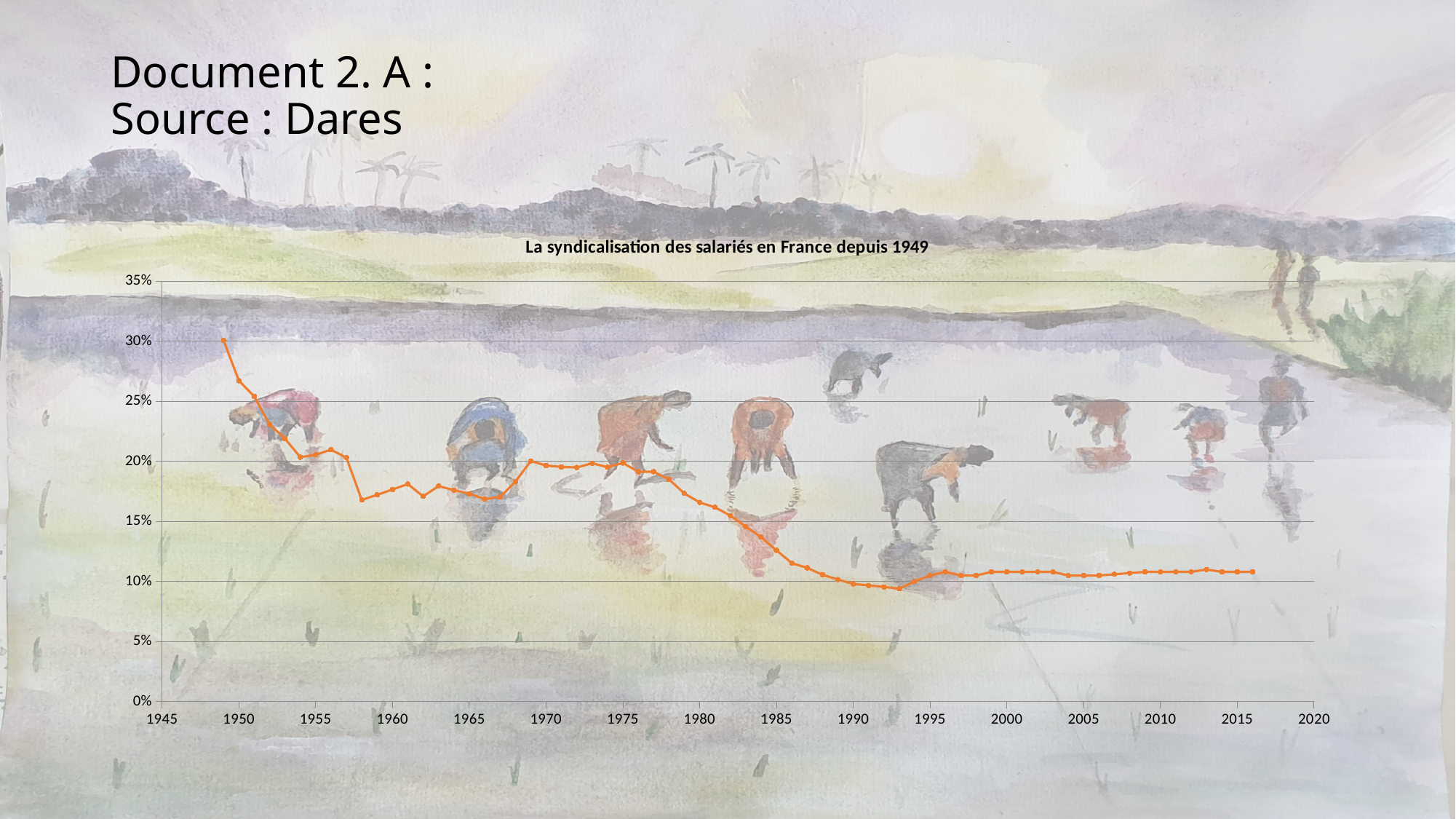
Is the value for 1949 greater or less than 25%? greater Is the value for 1970 greater or less than 15%? greater Which year has the larger value, 1975 or 1985? 1975 Do the values rise or fall between 1975 and 1990? fall Is the value for 1990 greater or less than 15%? less What colour is the plotted line? orange What is the title of the chart? La syndicalisation des salariés en France depuis 1949 In which year is the unionisation rate highest? 1949 Which year has the larger value, 1950 or 2010? 1950 What kind of chart is shown on the slide? line chart Overall, do the values rise or fall between 1949 and 2016? fall